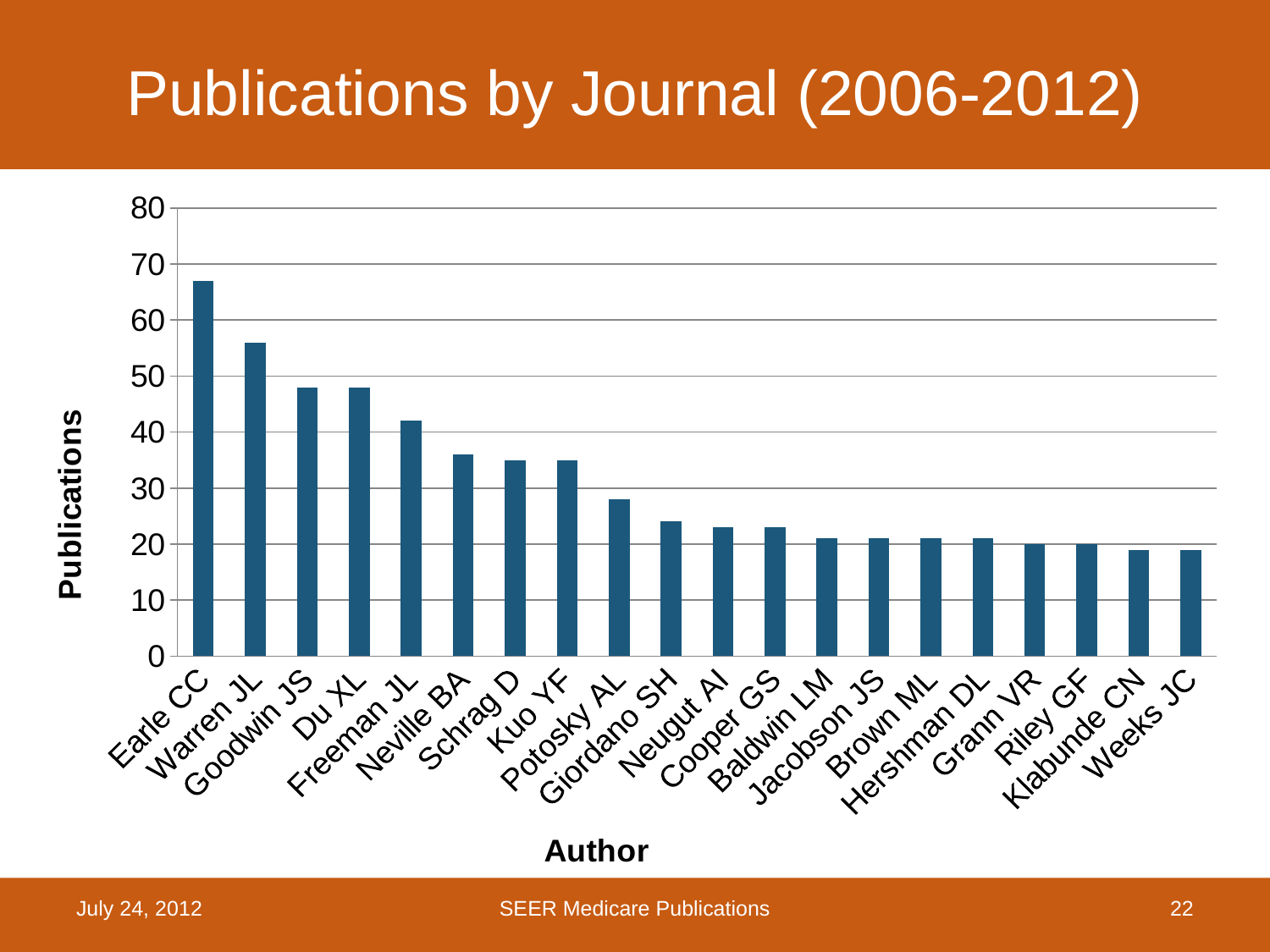
Do the values rise or fall moving from left to right along the x axis? fall What is the label on the y axis? Publications Is the value for Freeman JL greater or less than 40? greater What kind of chart is shown on the slide? bar chart Is the value for Potosky AL greater or less than 30? less Which has more publications, Neville BA or Potosky AL? Neville BA Which author has the highest number of publications? Earle CC Is the value for Warren JL greater or less than 50? greater Which has more publications, Earle CC or Warren JL? Earle CC How many authors are shown on the x axis? 20